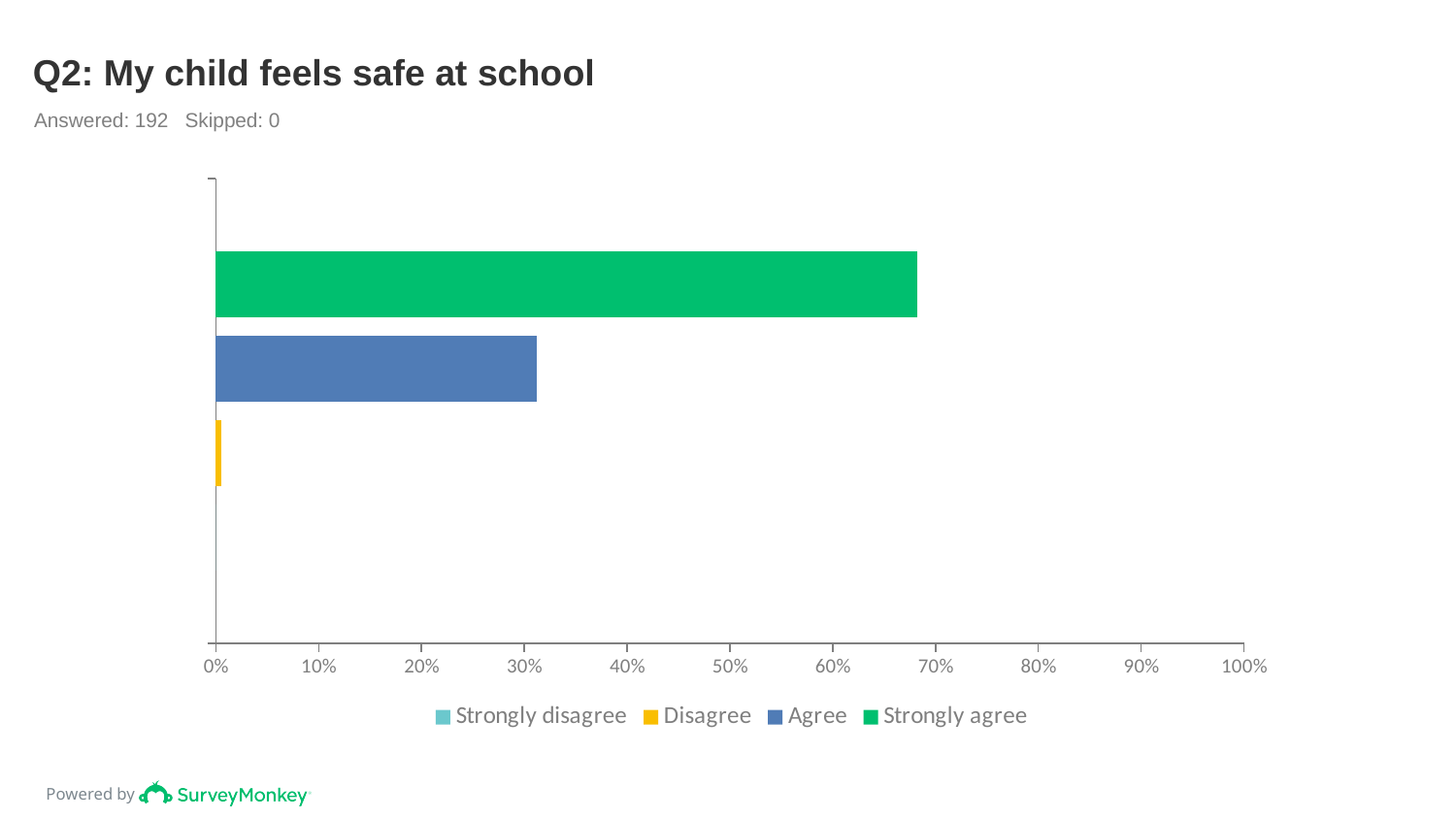
Is the value for Agree greater or less than 20%? greater What is the title of the chart? Q2: My child feels safe at school Is the value for Strongly agree greater or less than 70%? less Is the value for Agree greater or less than 40%? less What kind of chart is shown on the slide? bar chart How many series does the legend list? 4 Which response option has the highest value? Strongly agree Which is larger, the value for Strongly agree or the value for Agree? Strongly agree What colour represents Strongly agree in the legend? green Which is larger, the value for Agree or the value for Disagree? Agree